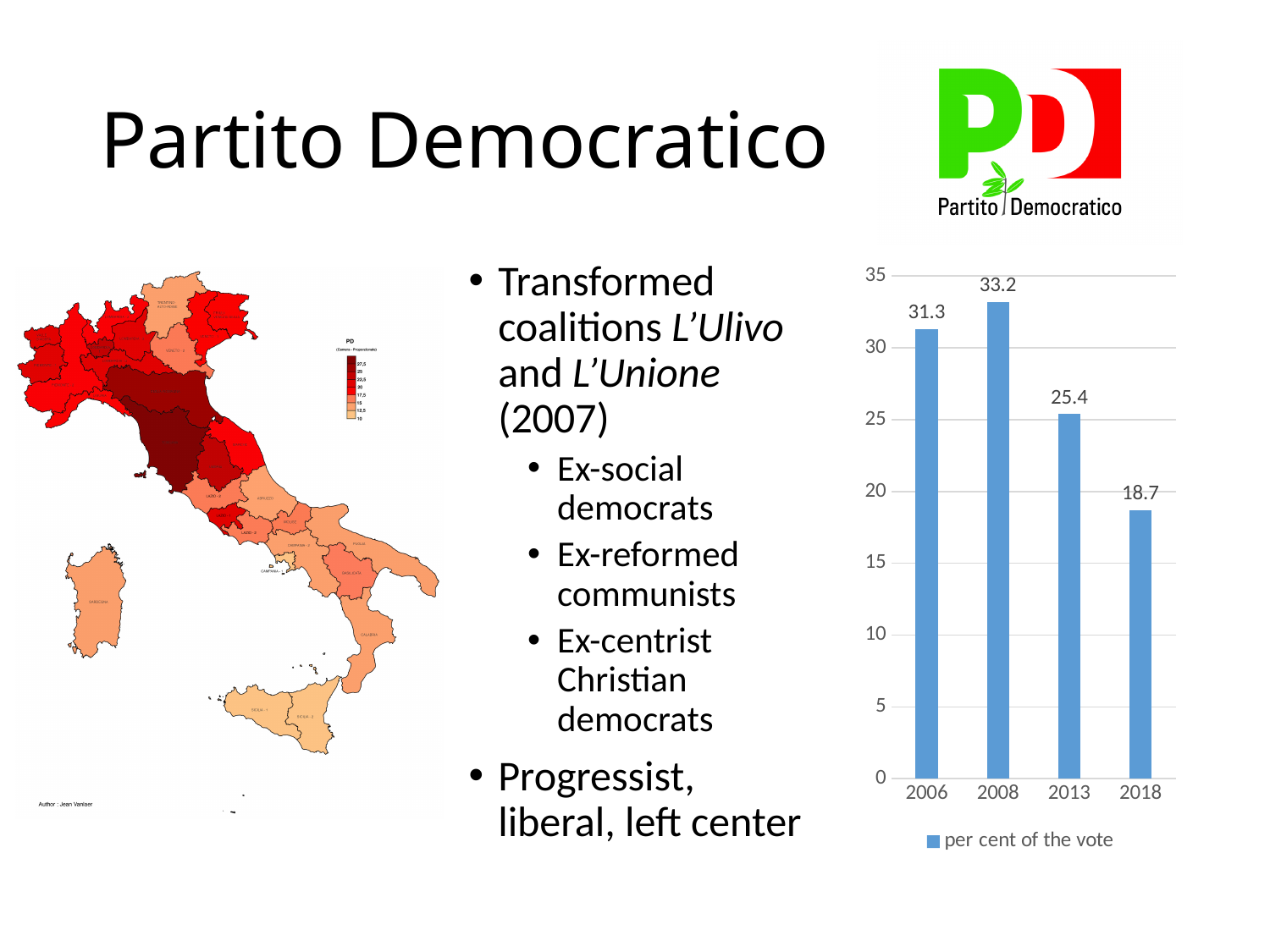
What is the per cent of the vote for 2018? 18.7 How many years are shown on the bar chart? 4 What kind of chart shows the per cent of the vote? bar chart Which is larger, the per cent of the vote in 2006 or in 2013? 2006 What is the per cent of the vote for 2006? 31.3 What is the per cent of the vote for 2013? 25.4 Does the per cent of the vote rise or fall from 2008 to 2018? fall Which year has the highest per cent of the vote? 2008 Which year has the lowest per cent of the vote? 2018 How many series does the legend of the bar chart list? 1 What is the per cent of the vote for 2008? 33.2 What is the difference between the per cent of the vote in 2008 and in 2018? 14.5